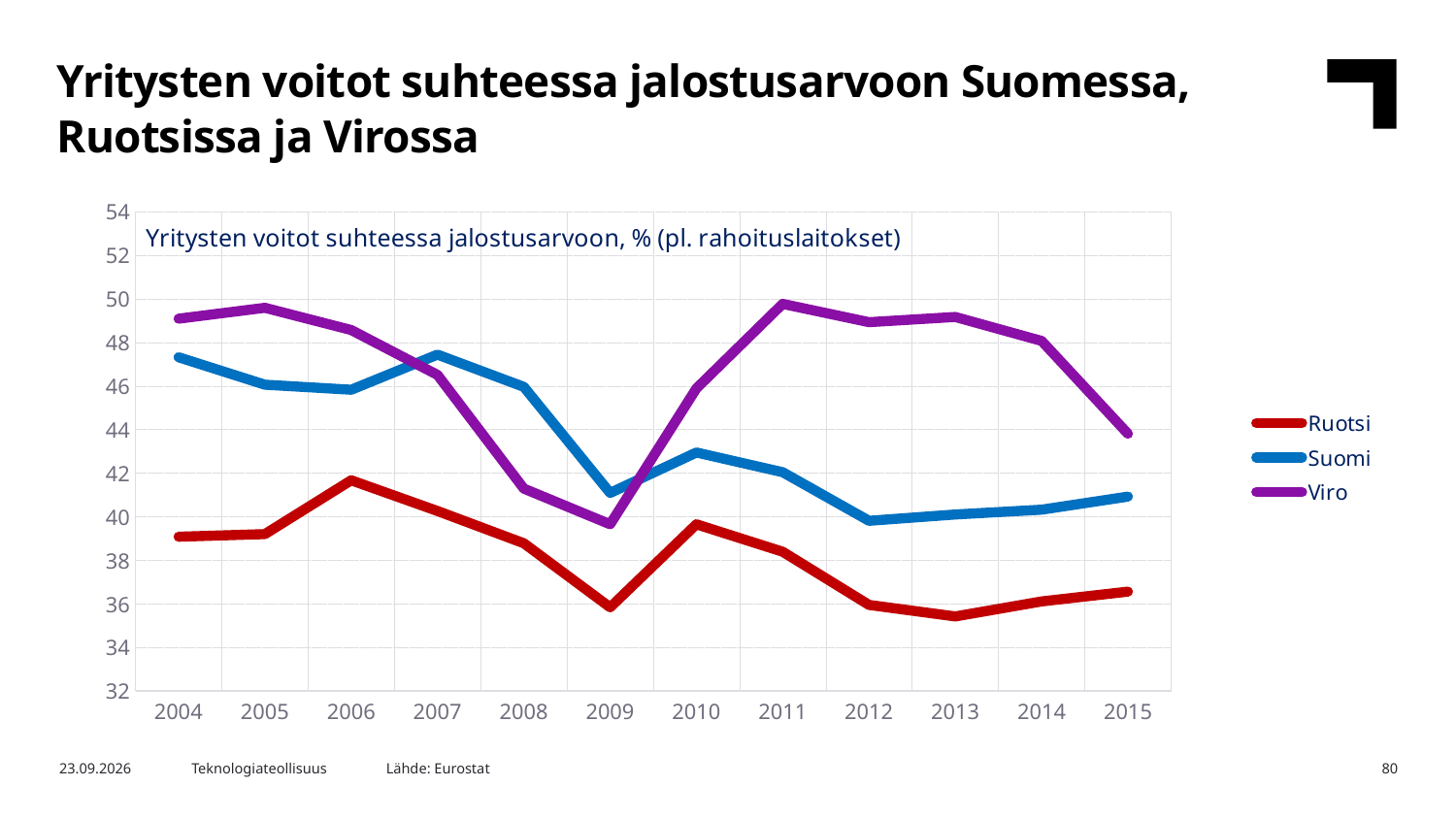
Is the value for Viro in 2015 greater or less than 46? less What kind of chart is shown on the slide? line chart What is the title printed inside the chart area? Yritysten voitot suhteessa jalostusarvoon, % (pl. rahoituslaitokset) Which series are listed in the legend? Ruotsi, Suomi, Viro Is the value for Viro in 2011 greater or less than 48? greater In 2013, which is higher, Suomi or Ruotsi? Suomi How many series does the legend list? 3 In which year does Ruotsi reach its highest value? 2006 Is the value for Suomi in 2004 greater or less than 46? greater In which year does Viro reach its lowest value? 2009 How many years are shown on the x axis? 12